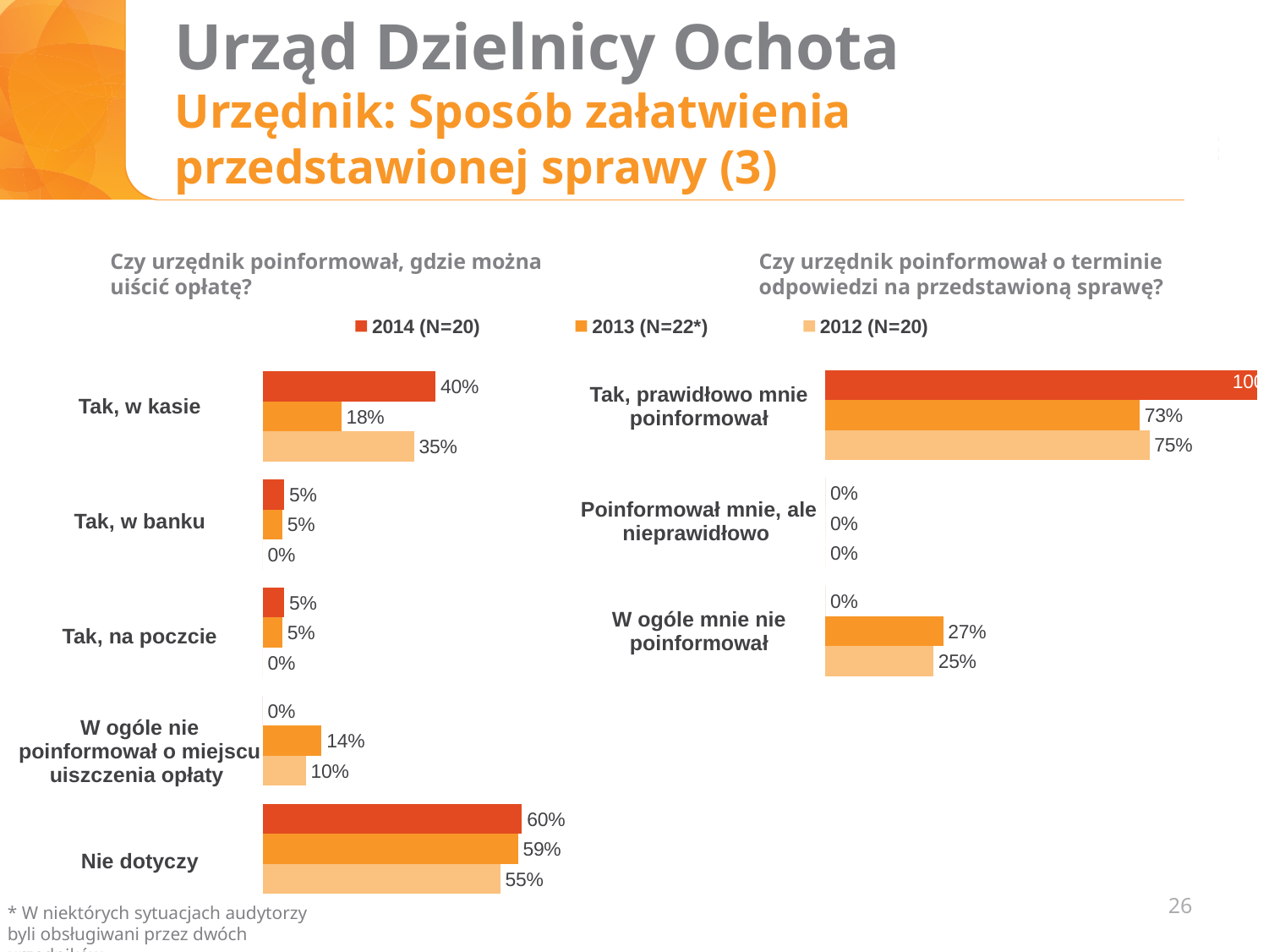
In the right chart (Czy urzędnik poinformował o terminie odpowiedzi na przedstawioną sprawę?), what is the difference between the 2013 and 2012 values for 'W ogóle mnie nie poinformował'? 2 percentage points In the left chart (Czy urzędnik poinformował, gdzie można uiścić opłatę?), what is the value for 'Tak, w kasie' in 2014 (N=20)? 40% In the right chart (Czy urzędnik poinformował o terminie odpowiedzi na przedstawioną sprawę?), what is the value for 'Tak, prawidłowo mnie poinformował' in 2013 (N=22*)? 73% In the left chart (Czy urzędnik poinformował, gdzie można uiścić opłatę?), which category has the highest value for 2013 (N=22*)? Nie dotyczy How many categories are shown in the left chart (Czy urzędnik poinformował, gdzie można uiścić opłatę?)? 5 In the left chart (Czy urzędnik poinformował, gdzie można uiścić opłatę?), which is larger for 'W ogóle nie poinformował o miejscu uiszczenia opłaty': the 2013 value or the 2012 value? 2013 (14%) What type of chart is used on this slide? Bar chart How many series does the legend list? 3 In the left chart (Czy urzędnik poinformował, gdzie można uiścić opłatę?), what is the difference between the 2014 and 2013 values for 'Tak, w kasie'? 22 percentage points In the right chart (Czy urzędnik poinformował o terminie odpowiedzi na przedstawioną sprawę?), what is the value for 'Poinformował mnie, ale nieprawidłowo' in 2014 (N=20)? 0% In the right chart (Czy urzędnik poinformował o terminie odpowiedzi na przedstawioną sprawę?), what is the value for 'W ogóle mnie nie poinformował' in 2012 (N=20)? 25% In the left chart (Czy urzędnik poinformował, gdzie można uiścić opłatę?), what is the value for 'Nie dotyczy' in 2012 (N=20)? 55%